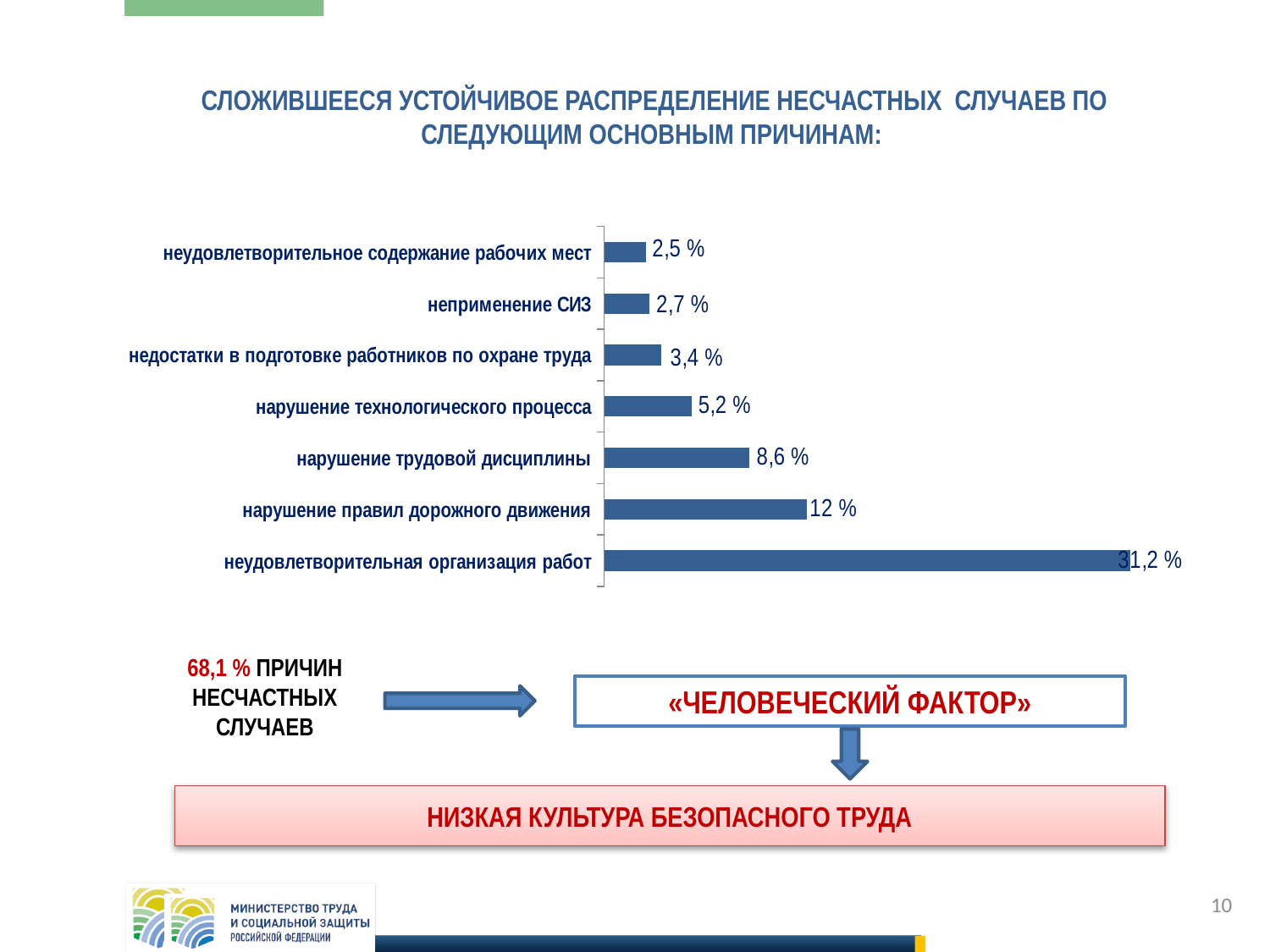
What is the value for «неприменение СИЗ»? 2,7 % Which category has the highest value? неудовлетворительная организация работ What is the value for «неудовлетворительная организация работ»? 31,2 % Which is larger: «нарушение технологического процесса» or «неприменение СИЗ»? нарушение технологического процесса What is the value for «нарушение трудовой дисциплины»? 8,6 % What is the difference between «неудовлетворительная организация работ» and «нарушение правил дорожного движения»? 19,2 % Which category has the lowest value? неудовлетворительное содержание рабочих мест What kind of chart is shown on the slide? bar chart What is the value for «недостатки в подготовке работников по охране труда»? 3,4 % How many categories are shown in the chart? 7 What is the value for «нарушение правил дорожного движения»? 12 % What is the difference between «нарушение трудовой дисциплины» and «нарушение технологического процесса»? 3,4 %